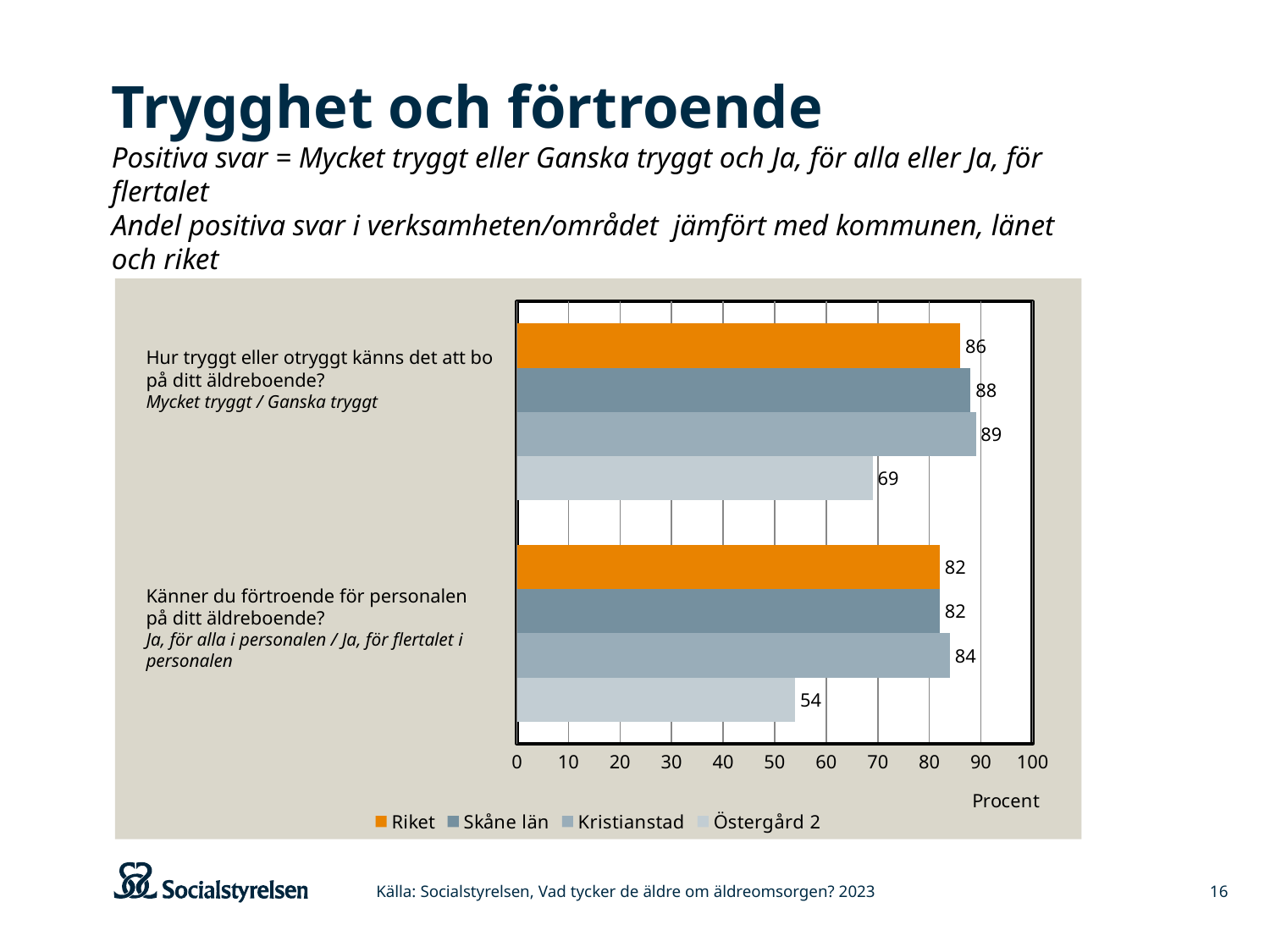
What is the value for Skåne län on the question "Känner du förtroende för personalen på ditt äldreboende?"? 82 What is the value for Östergård 2 on the question "Hur tryggt eller otryggt känns det att bo på ditt äldreboende?"? 69 Which series has the lowest value on the question "Känner du förtroende för personalen på ditt äldreboende?"? Östergård 2 What is the difference between the Kristianstad value and the Östergård 2 value on the question "Känner du förtroende för personalen på ditt äldreboende?"? 30 Which series has the highest value on the question "Hur tryggt eller otryggt känns det att bo på ditt äldreboende?"? Kristianstad What kind of chart is shown on the slide? Bar chart Which is larger for Östergård 2: the value for the trygghet question or the value for the förtroende question? The trygghet question (69) How many series does the legend list? 4 What is the value for Riket on the question "Hur tryggt eller otryggt känns det att bo på ditt äldreboende?"? 86 What is the difference between the Skåne län value and the Östergård 2 value on the question "Hur tryggt eller otryggt känns det att bo på ditt äldreboende?"? 19 What unit is shown on the horizontal axis of the chart? Procent What is the value for Kristianstad on the question "Känner du förtroende för personalen på ditt äldreboende?"? 84